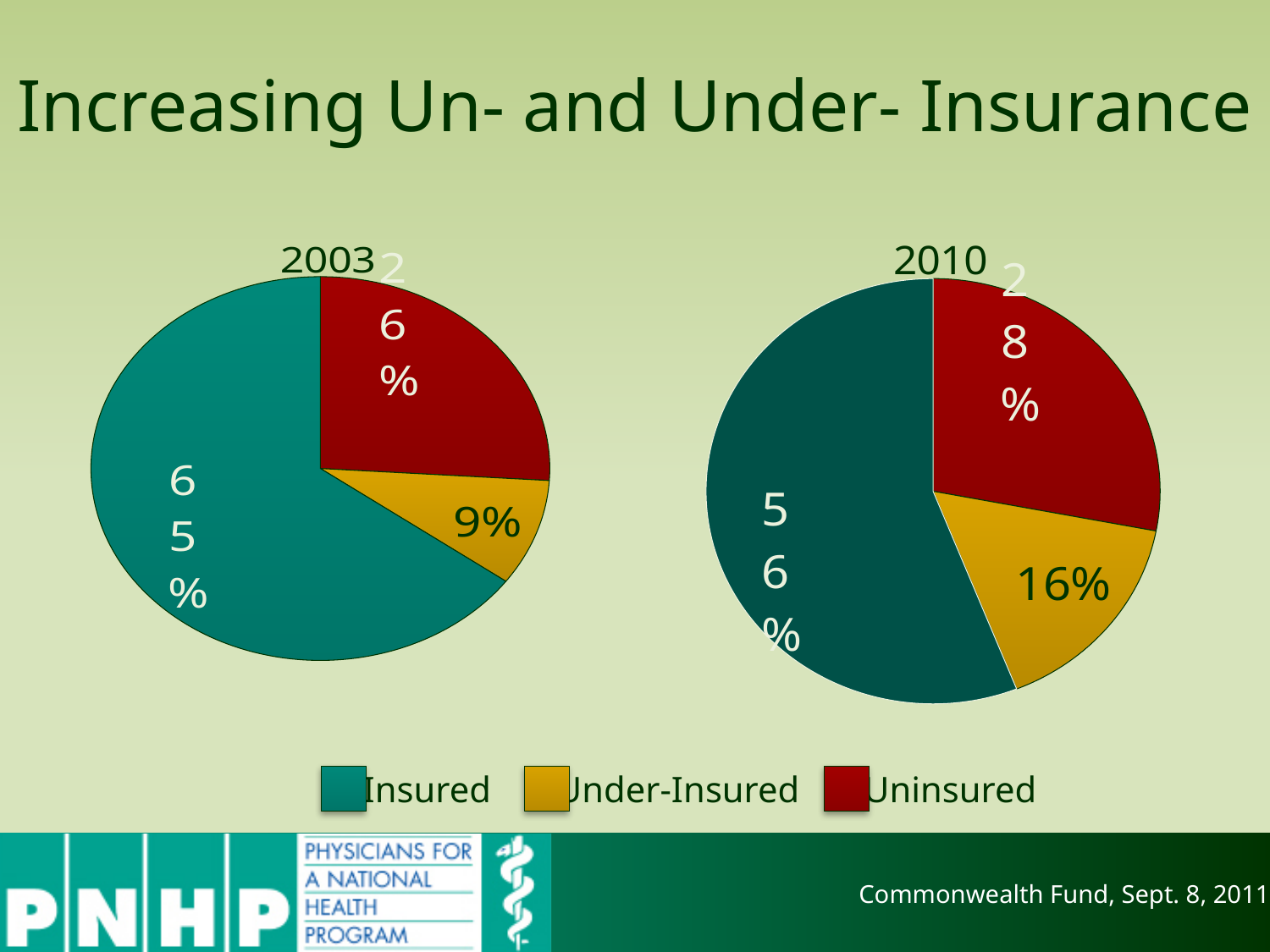
In the 2010 pie chart, what share is labelled for Uninsured? 28% In the 2003 pie chart, what share is labelled for Insured? 65% By how many percentage points did the Insured share fall from the 2003 pie chart to the 2010 pie chart? 9 percentage points What kind of charts are shown on the slide? Pie charts In the 2010 pie chart, what share is labelled for Under-Insured? 16% How many slices does each pie chart have? 3 How many categories does the legend list? 3 In the 2003 pie chart, which category has the smallest slice? Under-Insured Comparing the two pie charts, is the Under-Insured share larger in 2003 or in 2010? 2010 In the 2003 pie chart, what share is labelled for Under-Insured? 9% In the 2003 pie chart, which category has the largest slice? Insured In the 2010 pie chart, what share is labelled for Insured? 56%